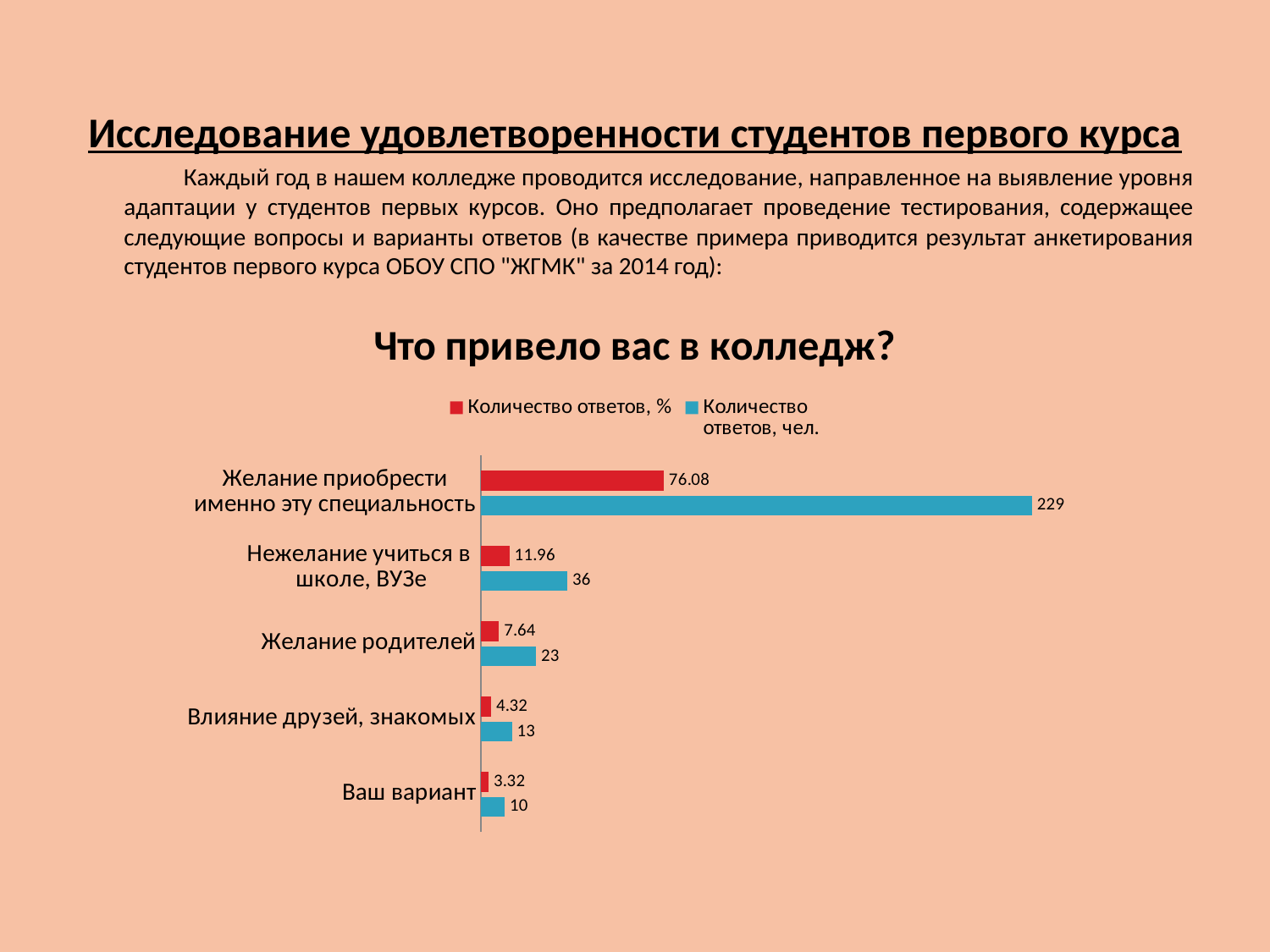
What type of chart is shown on the slide? Bar chart How many series does the legend list? 2 What is the value of 'Количество ответов, %' for 'Нежелание учиться в школе, ВУЗе'? 11.96 Which category has the highest value for 'Количество ответов, чел.'? Желание приобрести именно эту специальность How many categories are shown in the chart? 5 What is the value of 'Количество ответов, %' for 'Ваш вариант'? 3.32 What is the value of 'Количество ответов, чел.' for 'Желание приобрести именно эту специальность'? 229 Which has a larger 'Количество ответов, чел.' value: 'Желание родителей' or 'Влияние друзей, знакомых'? Желание родителей What is the difference in 'Количество ответов, чел.' between 'Нежелание учиться в школе, ВУЗе' and 'Влияние друзей, знакомых'? 23 Which category has the lowest value for 'Количество ответов, %'? Ваш вариант What is the title of the chart? Что привело вас в колледж? What is the value of 'Количество ответов, чел.' for 'Желание родителей'? 23